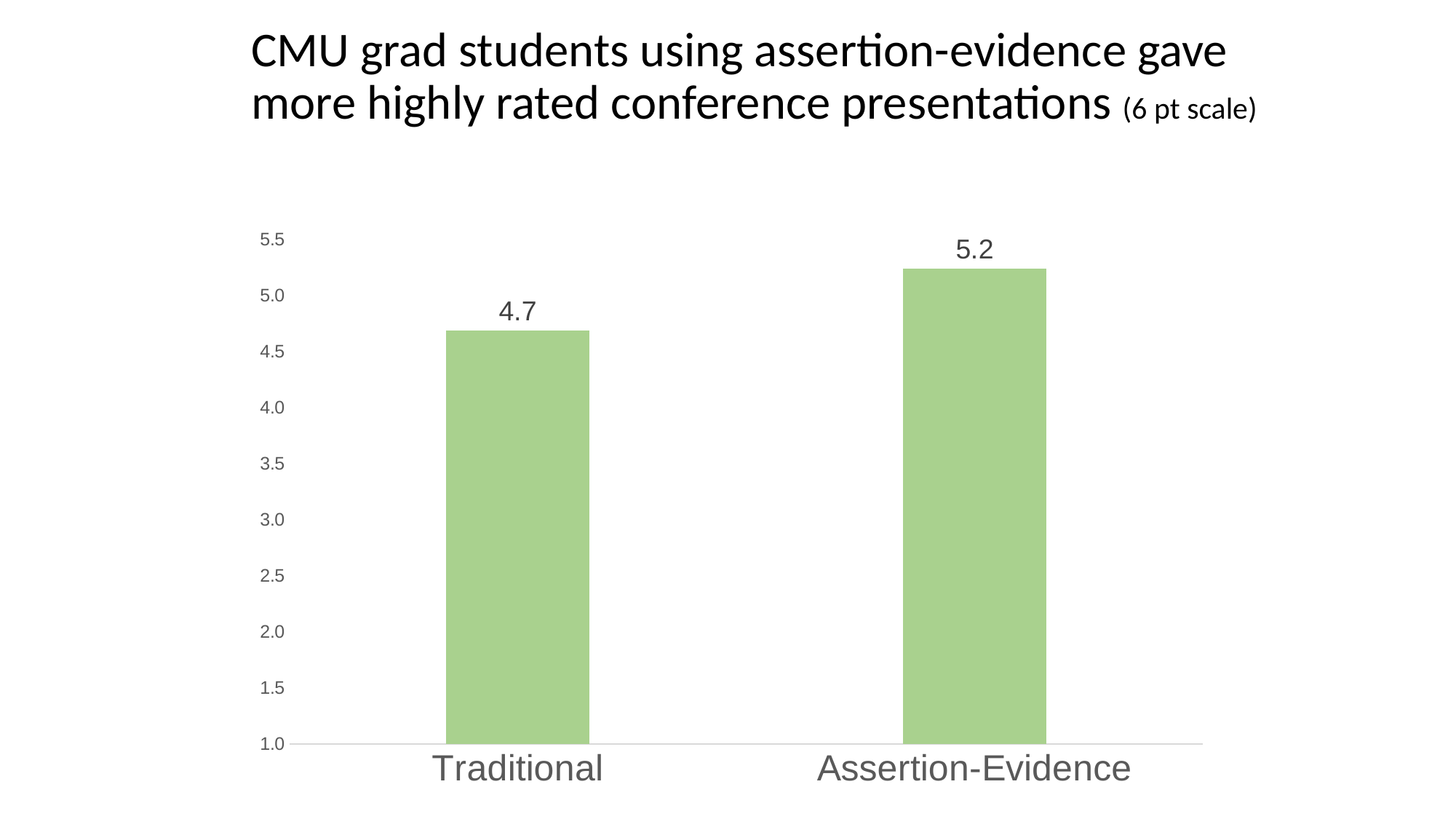
What is the rating for Assertion-Evidence? 5.2 Is the value for Assertion-Evidence greater or less than 5.0? greater What kind of chart is shown on the slide? bar chart What rating scale is mentioned in the slide title? 6 pt scale What is the rating for Traditional? 4.7 Which category has the lowest rating? Traditional What is the lowest value shown on the y axis? 1.0 How many categories are shown on the x axis? 2 What is the difference between the Assertion-Evidence and Traditional ratings? 0.5 Which is larger, the rating for Traditional or for Assertion-Evidence? Assertion-Evidence Is the value for Traditional greater or less than 5.0? less Which category has the highest rating? Assertion-Evidence